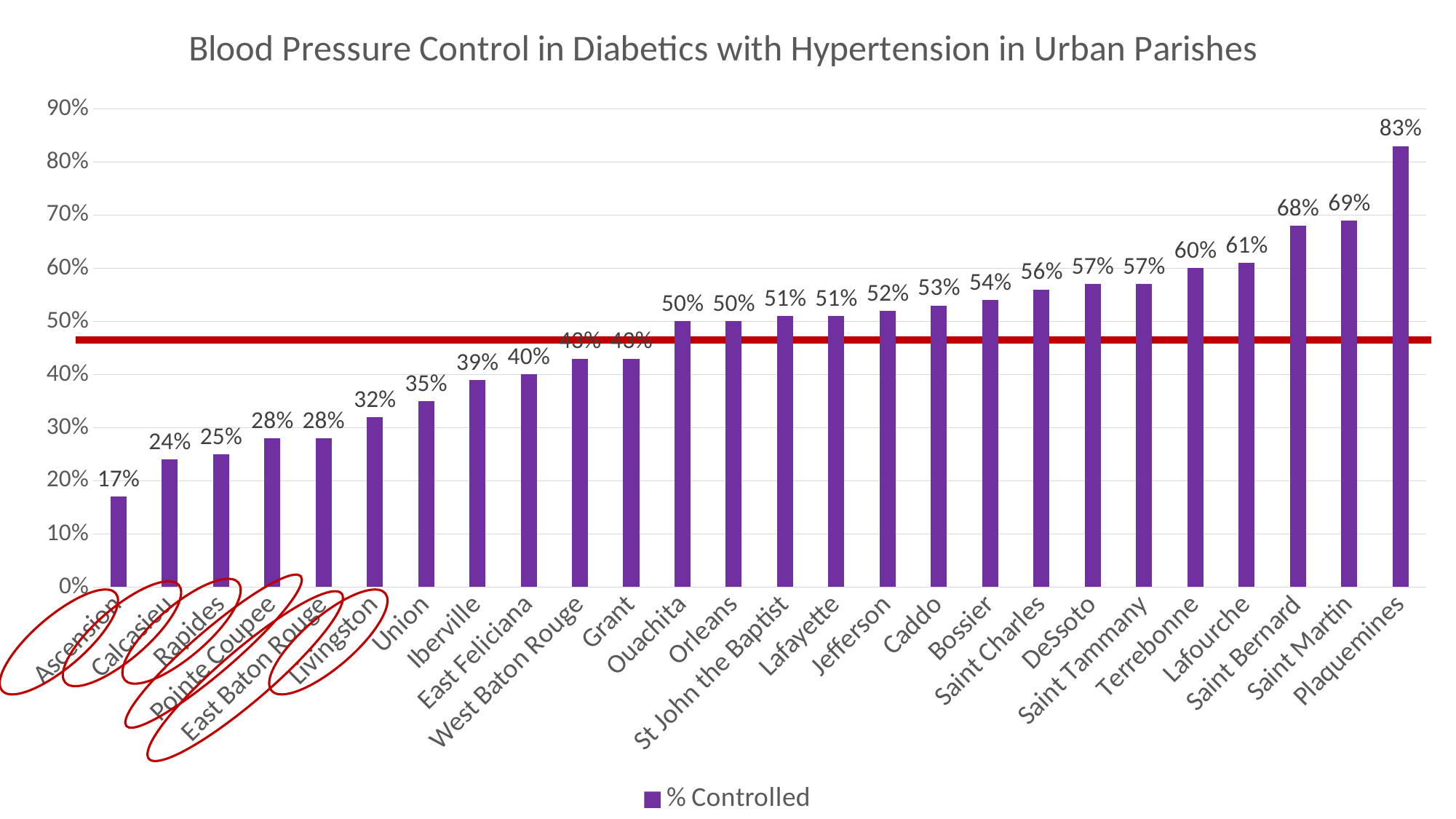
Which parish has the highest % Controlled value? Plaquemines What is the % Controlled value for Plaquemines? 83% What is the % Controlled value for Jefferson? 52% What kind of chart is shown on the slide? Bar chart What is the difference in % Controlled between Plaquemines and Ascension? 66 percentage points Which has a higher % Controlled value, Saint Bernard or Caddo? Saint Bernard Which parish has the lowest % Controlled value? Ascension What is the % Controlled value for Ascension? 17% How many parishes are shown on the chart? 26 What is the title of the chart? Blood Pressure Control in Diabetics with Hypertension in Urban Parishes Do the % Controlled values rise or fall from left to right along the x axis? Rise How many series does the legend list? 1